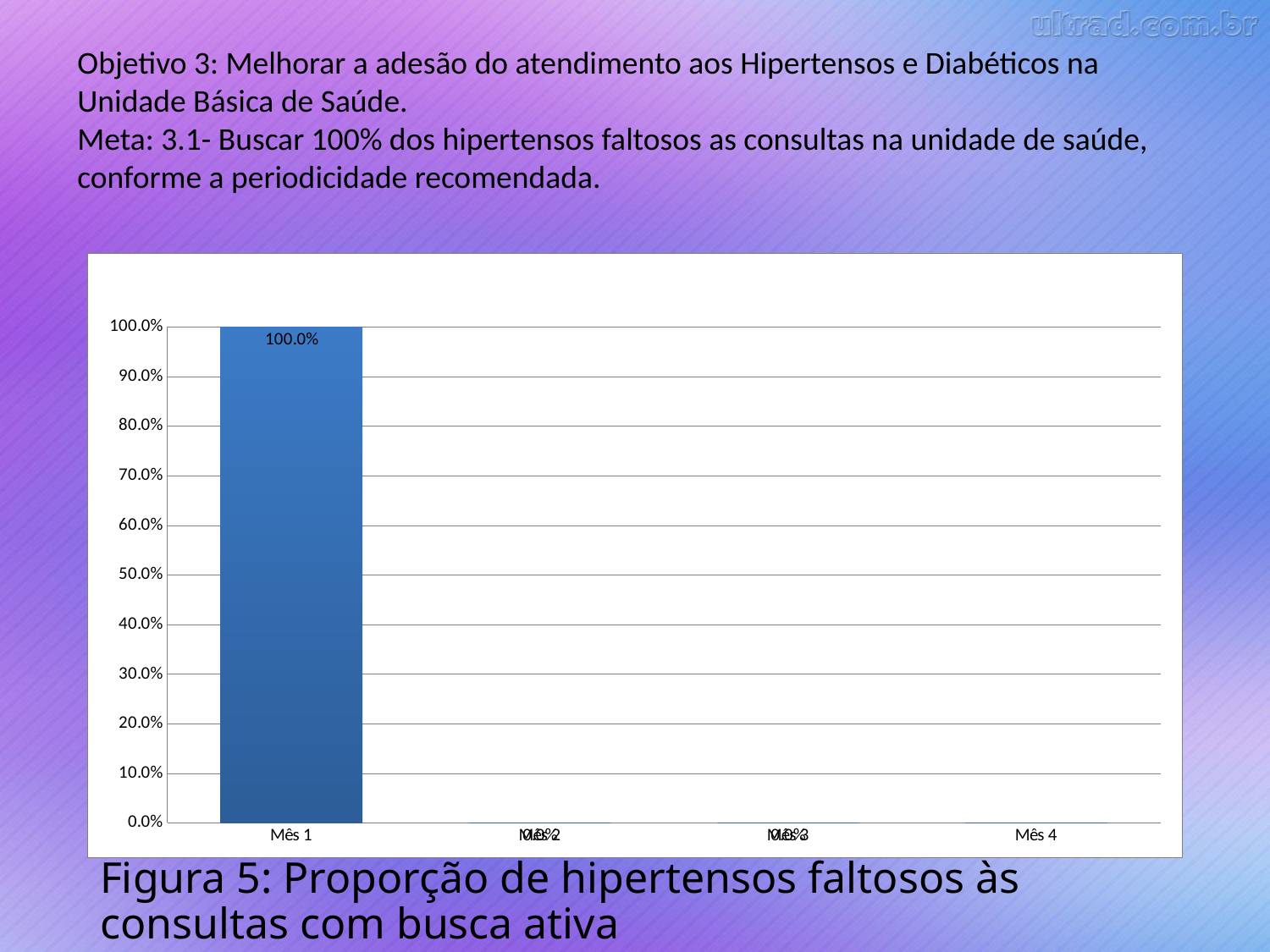
What is the highest value shown on the y axis? 100.0% What is the value for Mês 1? 100.0% What kind of chart is shown on the slide? bar chart What is the figure caption below the chart? Figura 5: Proporção de hipertensos faltosos às consultas com busca ativa Which month has the highest value? Mês 1 How many months are shown on the x axis? 4 Do the values rise or fall from Mês 1 to Mês 4? fall Is the value for Mês 4 greater or less than 10.0%? less Is the value for Mês 2 greater or less than 50.0%? less Which is larger, the value for Mês 1 or the value for Mês 4? Mês 1